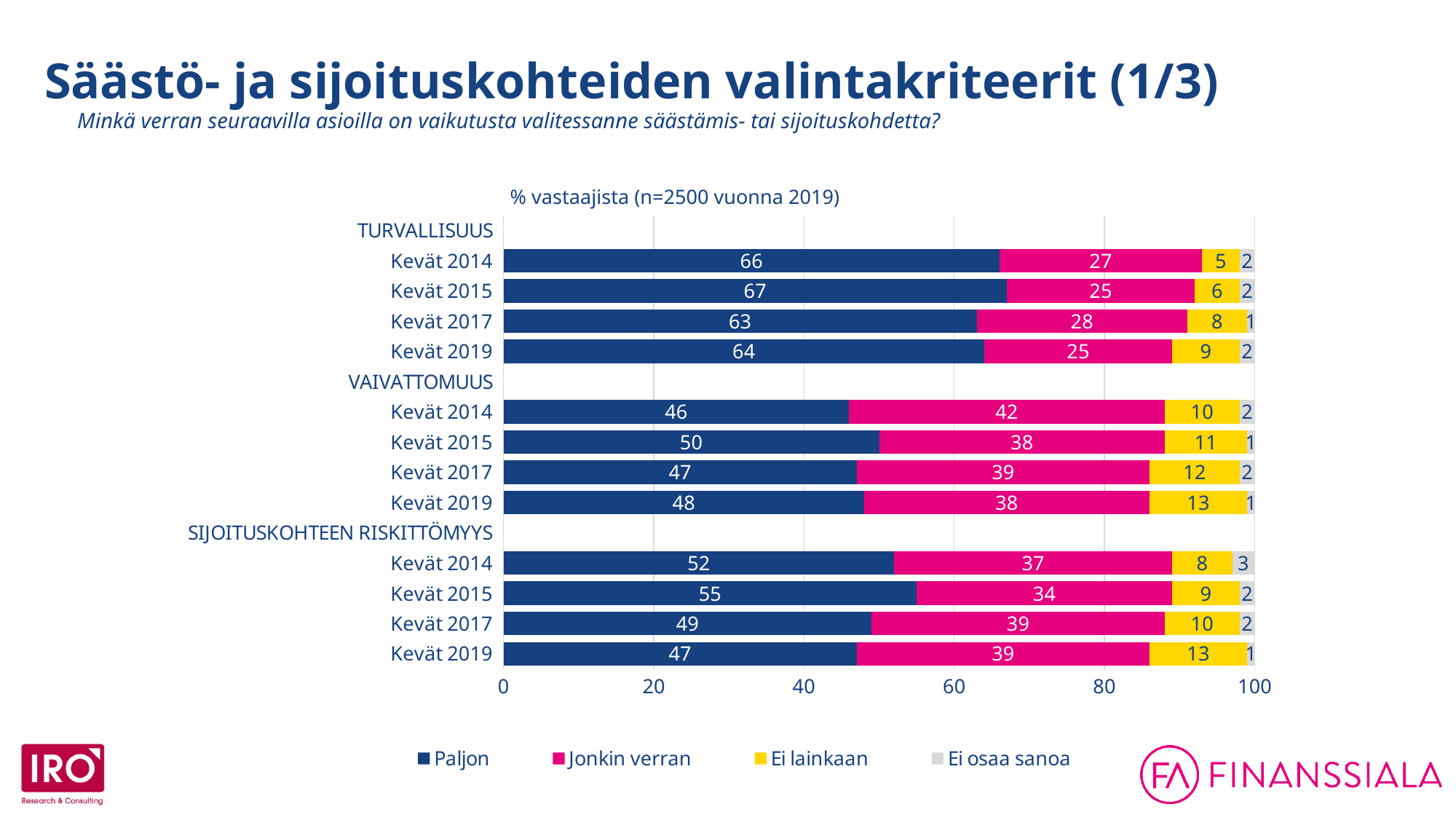
How many bars (year rows) are plotted in the chart in total? 12 What is the 'Paljon' value for Turvallisuus, Kevät 2015? 67 What kind of chart is shown on the slide? Stacked bar chart What is the 'Ei lainkaan' value for Sijoituskohteen riskittömyys, Kevät 2019? 13 How many series does the legend list? 4 Within the Turvallisuus group, which year has the highest 'Paljon' value? Kevät 2015 Within the Vaivattomuus group, which year has the lowest 'Paljon' value? Kevät 2014 What is the difference between the 'Paljon' values for Sijoituskohteen riskittömyys in Kevät 2015 and Kevät 2019? 8 What is the total of the stacked bar for Vaivattomuus, Kevät 2015? 100 What is the 'Jonkin verran' value for Vaivattomuus, Kevät 2014? 42 What is the 'Ei osaa sanoa' value for Sijoituskohteen riskittömyys, Kevät 2014? 3 Which is larger: the 'Jonkin verran' value for Turvallisuus, Kevät 2017 or for Turvallisuus, Kevät 2019? Kevät 2017